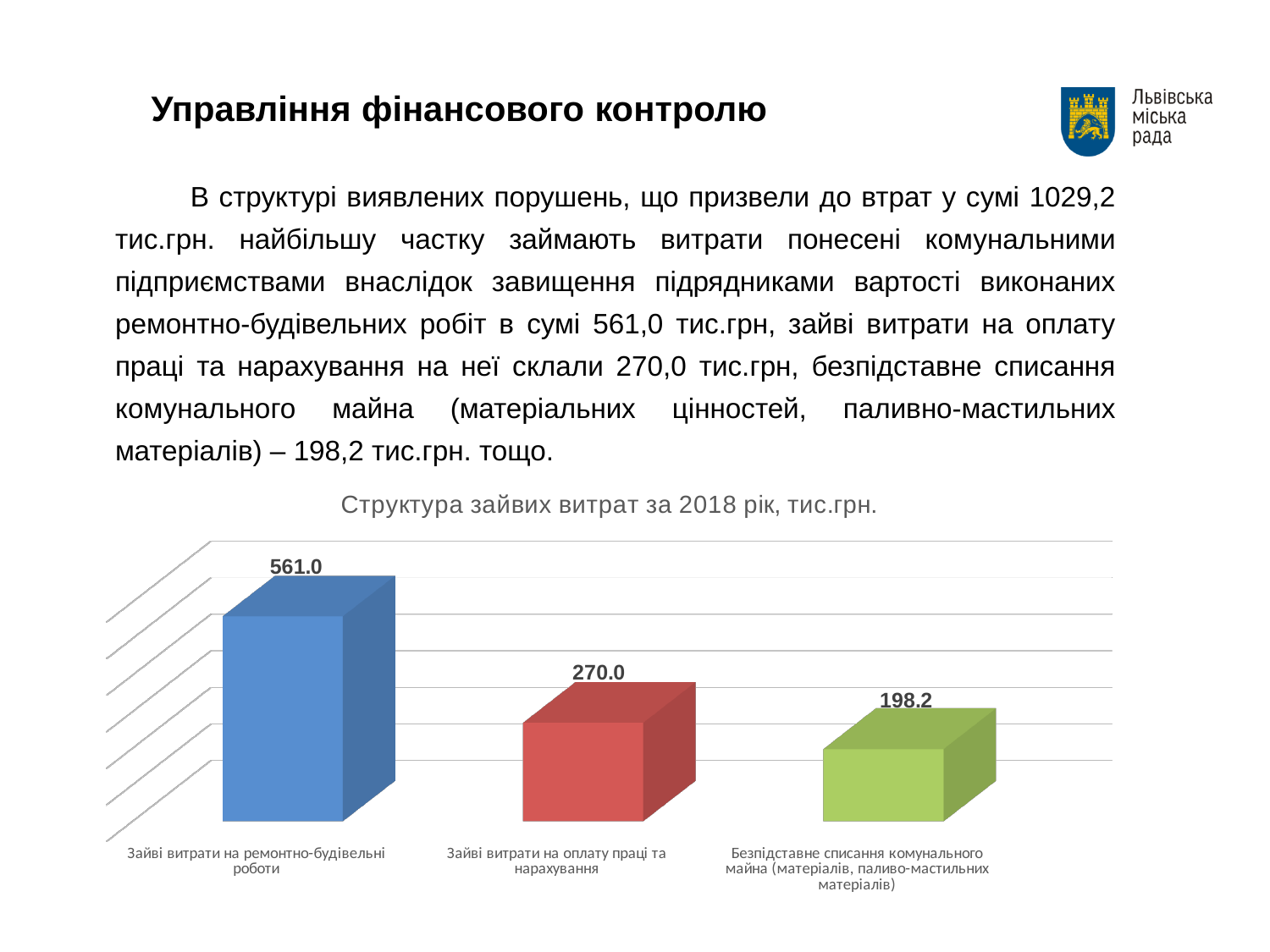
Which category has the lowest value? Безпідставне списання комунального майна (матеріалів, паливо-мастильних матеріалів) Which category has the highest value? Зайві витрати на ремонтно-будівельні роботи What is the value for 'Зайві витрати на оплату праці та нарахування'? 270.0 What is the difference between the value for 'Зайві витрати на оплату праці та нарахування' and the value for 'Безпідставне списання комунального майна'? 71.8 What kind of chart is shown on the slide? Bar chart What is the value for 'Зайві витрати на ремонтно-будівельні роботи'? 561.0 What is the value for 'Безпідставне списання комунального майна (матеріалів, паливо-мастильних матеріалів)'? 198.2 How many categories are shown in the chart? 3 What is the difference between the value for 'Зайві витрати на ремонтно-будівельні роботи' and the value for 'Зайві витрати на оплату праці та нарахування'? 291.0 Which is larger: the value for 'Зайві витрати на оплату праці та нарахування' or the value for 'Безпідставне списання комунального майна'? Зайві витрати на оплату праці та нарахування What is the title of the chart? Структура зайвих витрат за 2018 рік, тис.грн. Do the values rise or fall from left to right across the categories? Fall